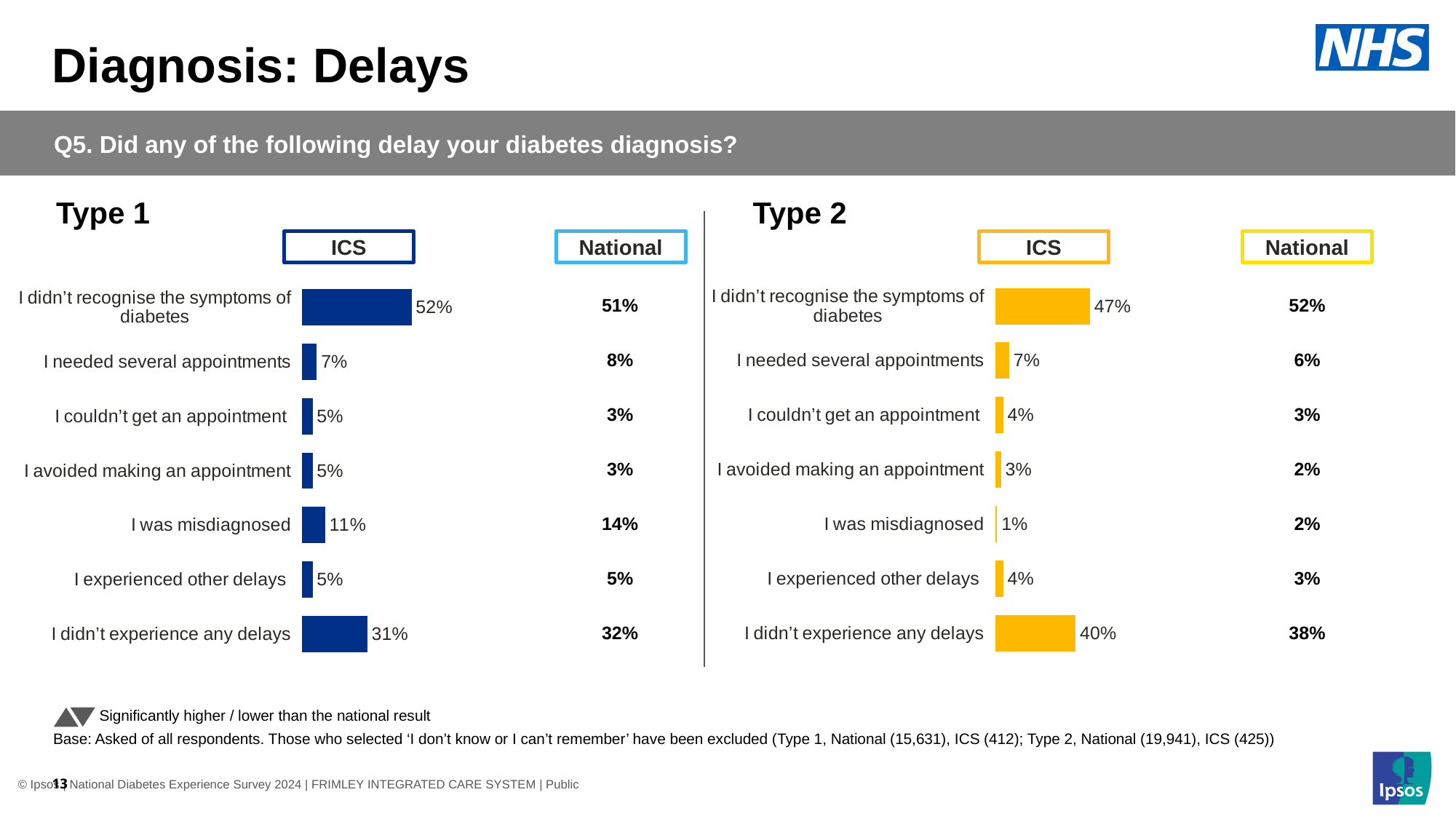
What colour are the ICS bars in the Type 2 chart? Yellow/orange In the Type 1 chart, which category has the highest ICS value? I didn't recognise the symptoms of diabetes In the Type 2 chart, what is the National value for 'I needed several appointments'? 6% What kind of chart is used to show the ICS values in the Type 1 section? bar chart In the Type 2 chart, what is the ICS value for 'I didn't experience any delays'? 40% In the Type 2 chart, what is the difference between the ICS and National values for 'I didn't recognise the symptoms of diabetes'? 5% In the Type 1 chart, what is the difference between the ICS and National values for 'I was misdiagnosed'? 3% In the Type 1 chart, what is the ICS value for 'I didn't recognise the symptoms of diabetes'? 52% How many categories are shown in the Type 1 chart? 7 In the Type 2 chart, is the ICS value for 'I didn't experience any delays' larger or smaller than the National value? larger In the Type 1 chart, what is the National value for 'I was misdiagnosed'? 14% In the Type 2 chart, which category has the lowest ICS value? I was misdiagnosed